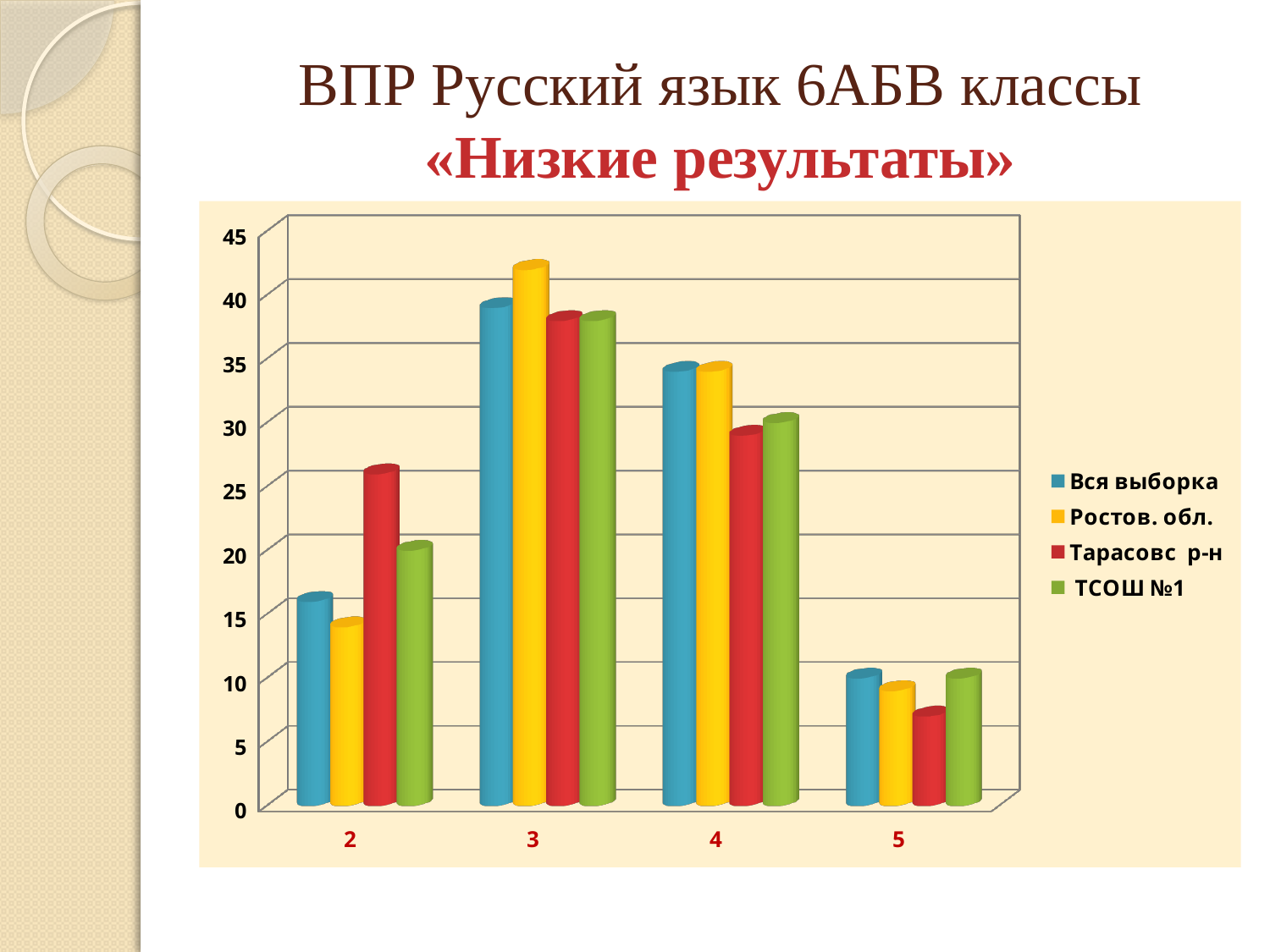
For which category is the value for Ростов. обл. highest? 3 Which series has the highest value in category 3? Ростов. обл. How many categories are shown on the x axis? 4 What kind of chart is shown on the slide? bar chart Is the value for Тарасовс р-н in category 2 greater or less than 20? greater Is the value for Вся выборка in category 4 greater or less than 30? greater In category 2, which is larger: Тарасовс р-н or Вся выборка? Тарасовс р-н Is the value for Ростов. обл. in category 3 greater or less than 40? greater For which category is the value for Тарасовс р-н lowest? 5 How many series does the legend list? 4 In category 4, which is larger: Вся выборка or Тарасовс р-н? Вся выборка